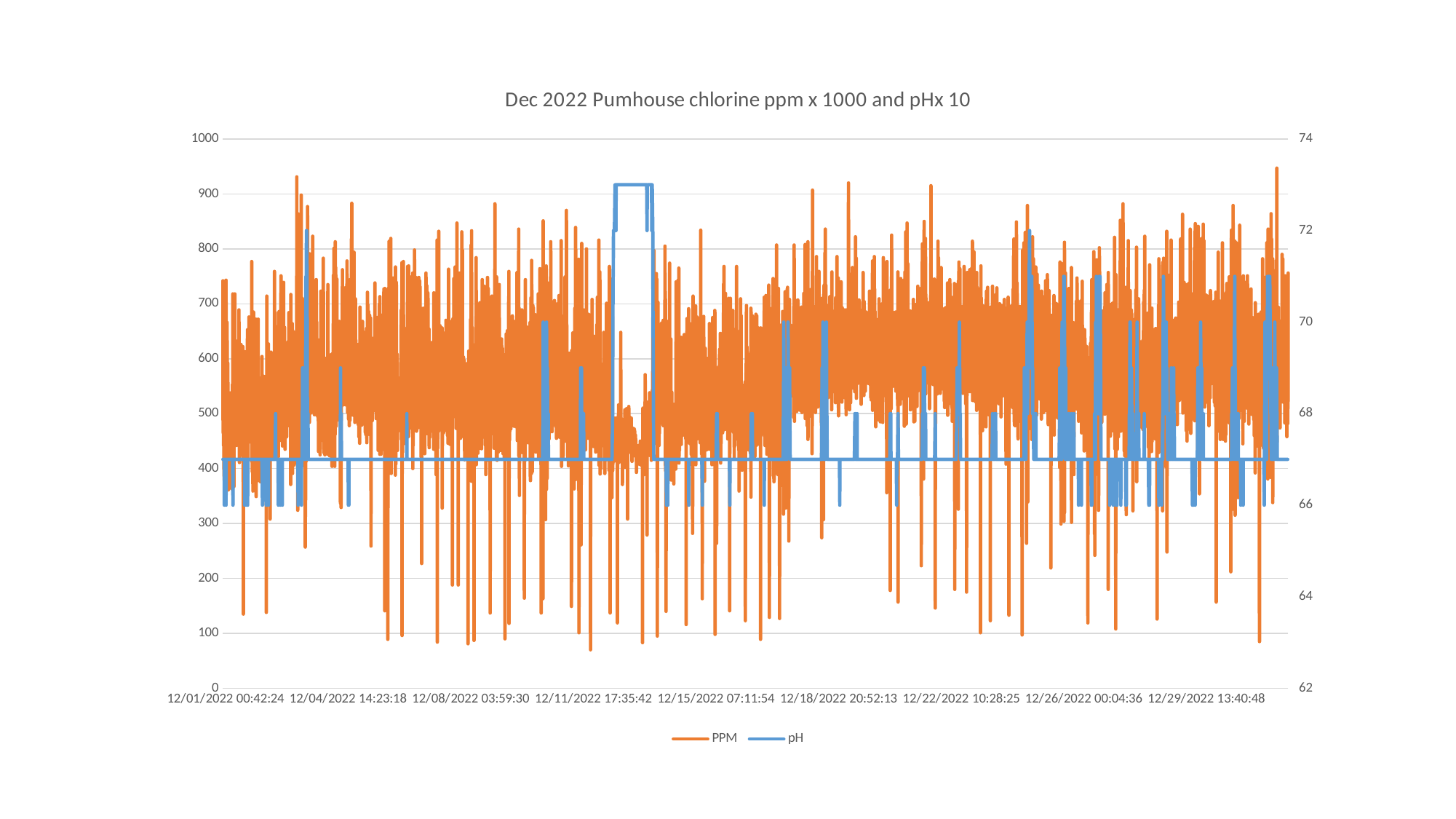
What is the title of the chart? Dec 2022 Pumhouse chlorine ppm x 1000 and pHx 10 Is the lowest pH value on the chart greater or less than 64 on the right axis? greater How many series does the legend list? 2 Is the highest pH value on the chart greater or less than 72 on the right axis? greater Is the highest PPM value on the chart greater or less than 900 on the left axis? greater Which series is drawn in orange? PPM What kind of chart is shown on the slide? line chart How many date labels are shown along the x axis? 9